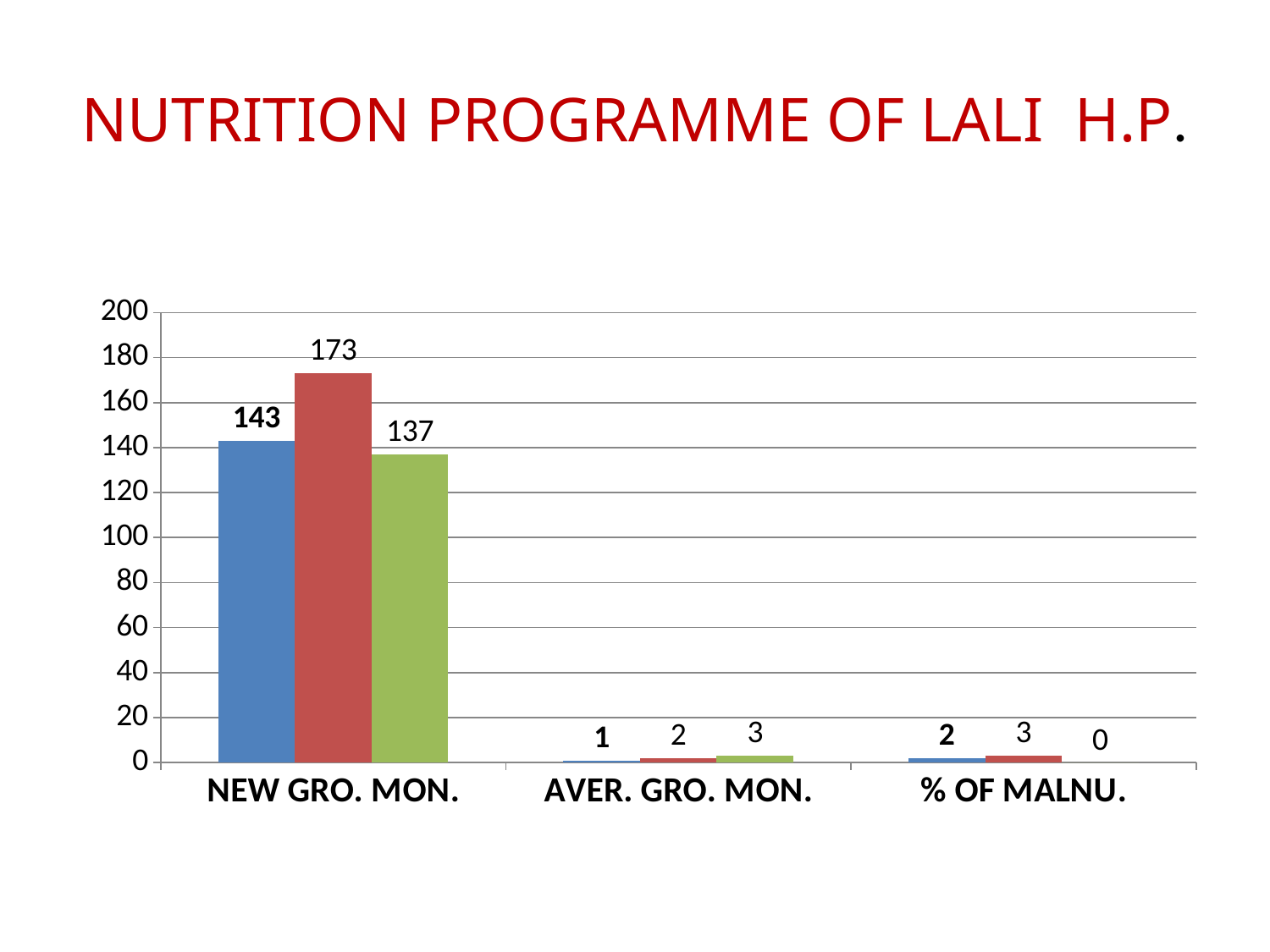
What is the difference between the red and blue bars for NEW GRO. MON.? 30 Which bar colour has the highest value for NEW GRO. MON.? red What is the value of the blue bar for NEW GRO. MON.? 143 What is the title of the slide containing the chart? NUTRITION PROGRAMME OF LALI H.P. What type of chart is shown on the slide? bar chart What is the value of the red bar for AVER. GRO. MON.? 2 What is the value of the red bar for NEW GRO. MON.? 173 What is the value of the green bar for NEW GRO. MON.? 137 Which bar colour has the lowest value for % OF MALNU.? green How many categories are shown on the x axis? 3 Which is larger for NEW GRO. MON., the blue bar or the green bar? blue bar What is the value of the green bar for % OF MALNU.? 0